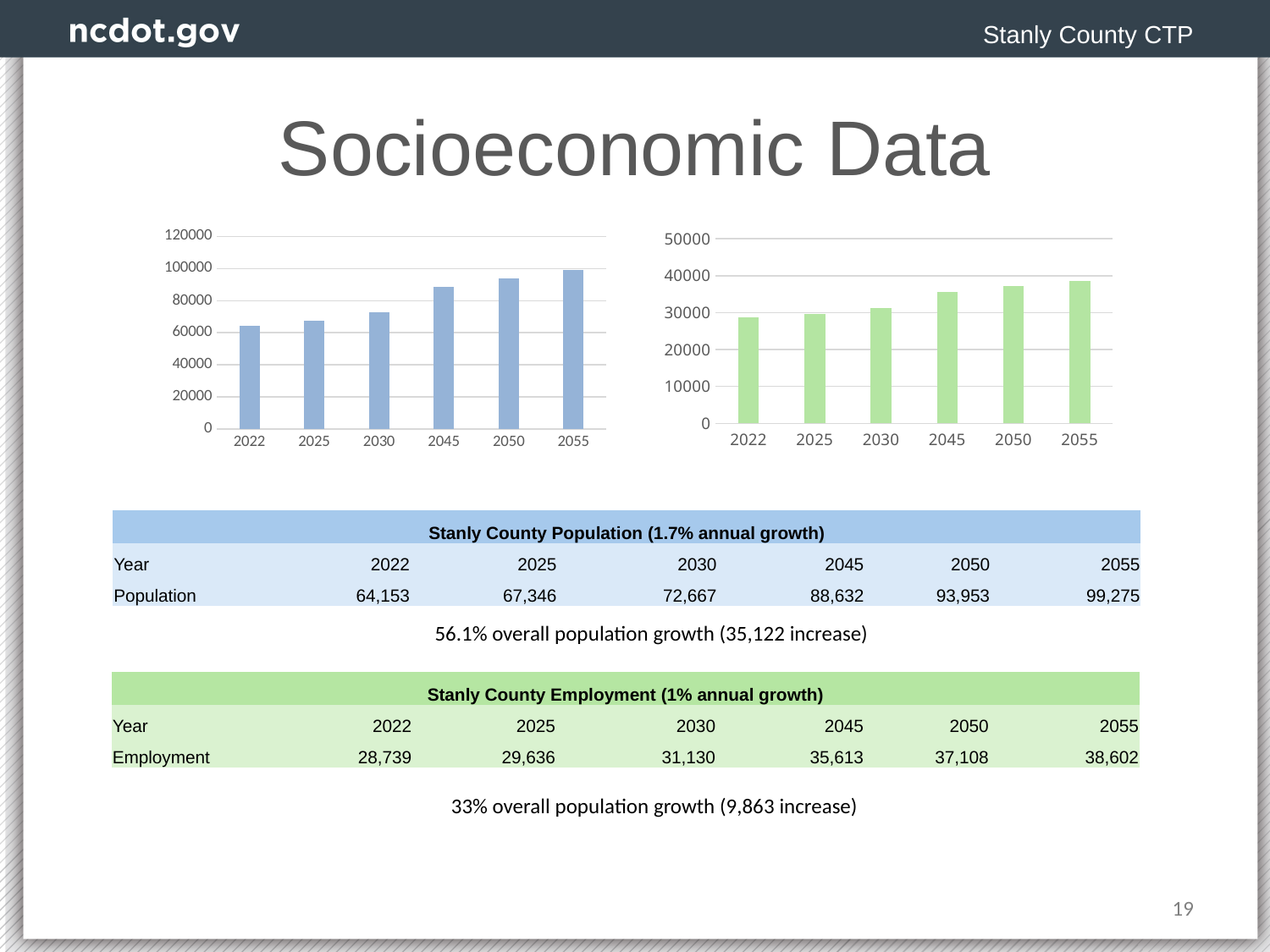
What colour are the bars on the right chart? green On the left chart, is the value for 2045 greater or less than 80000? greater On the right chart, is the value for 2045 greater or less than 40000? less What kind of chart is the right chart on the slide? bar chart What kind of chart is the left chart on the slide? bar chart On the left chart, do the values rise or fall from 2022 to 2055? rise On the left chart, is the value for 2030 greater or less than 80000? less On the left chart, which year has the highest bar? 2055 On the right chart, which year has the highest bar? 2055 On the left chart, which year has the lowest bar? 2022 How many years are plotted on the left chart? 6 On the left chart, which is larger, the value for 2050 or the value for 2030? 2050